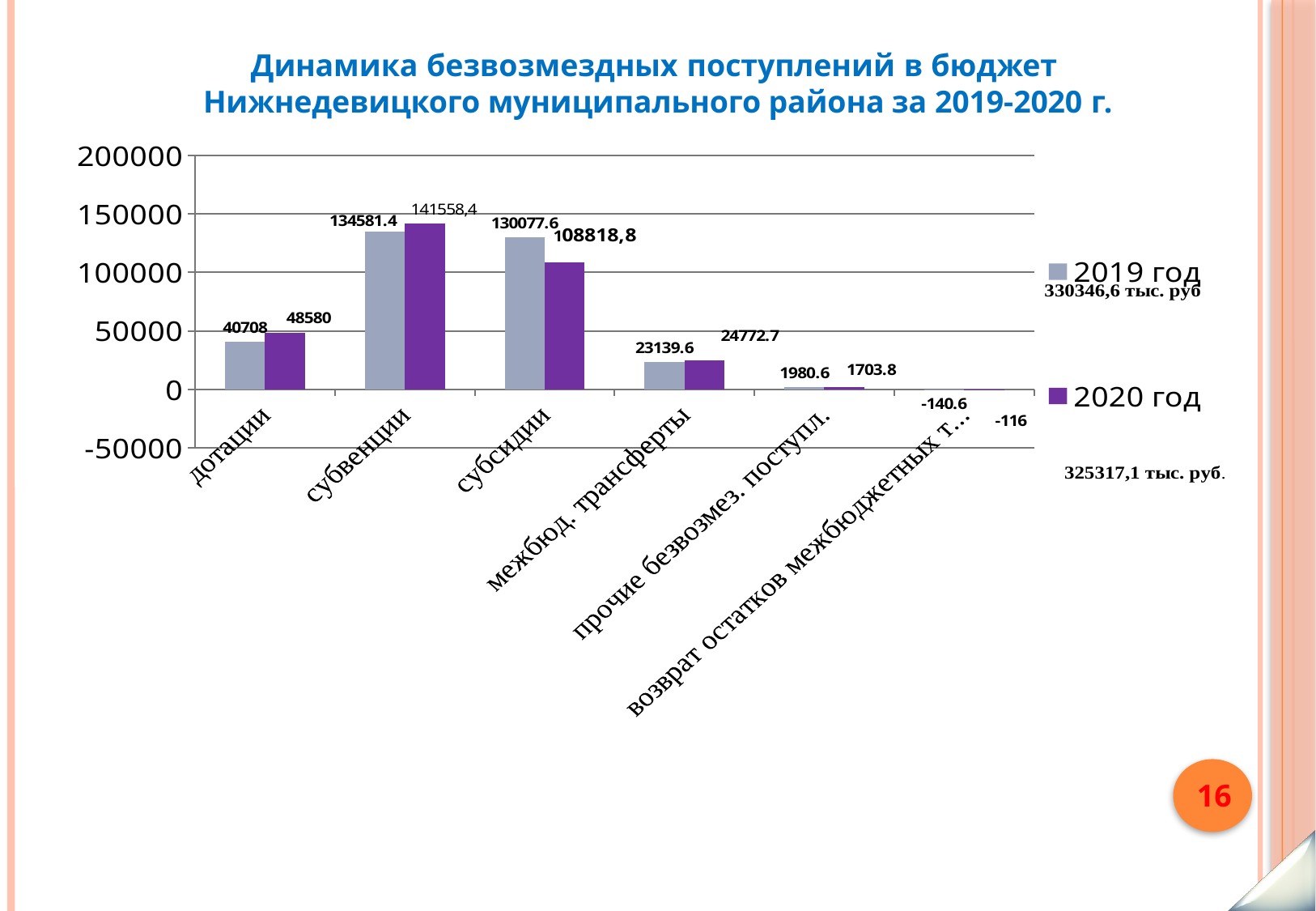
Which category has the highest value for 2020 год? субвенции What is the difference between the 2020 год and 2019 год values for дотации? 7872 What is the value for дотации in 2020 год? 48580 How many series does the legend list? 2 What is the value for субсидии in 2020 год? 108818,8 What is the value for субвенции in 2019 год? 134581.4 What is the value for межбюд. трансферты in 2019 год? 23139.6 Which is larger for субсидии: the 2019 год value or the 2020 год value? 2019 год What type of chart is shown on the slide? bar chart What total is shown next to the 2019 год legend entry? 330346,6 тыс. руб How many categories are shown on the x axis? 6 Is the value for дотации in 2019 год greater or less than 50000? less